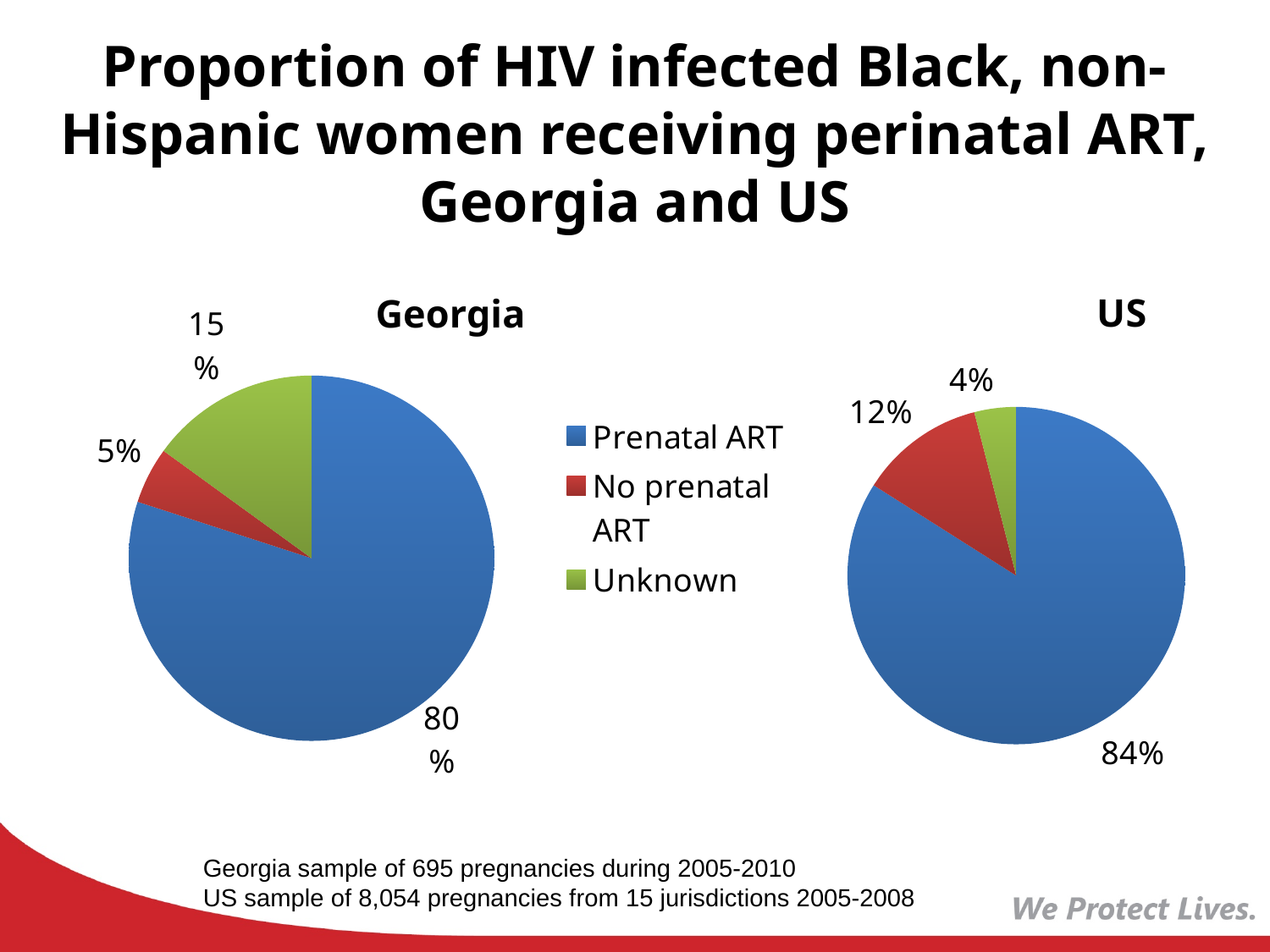
Which chart shows a larger share for No prenatal ART, Georgia or US? US In the US pie chart, what percentage of women received prenatal ART? 84% In the US pie chart, what is the share for No prenatal ART? 12% In the Georgia pie chart, which category has the largest slice? Prenatal ART How many categories does the legend list? 3 What type of chart is used on this slide? Pie chart In the US pie chart, which category has the smallest slice? Unknown In the US pie chart, what is the share for Unknown? 4% In the Georgia pie chart, what is the share for Unknown? 15% In the Georgia pie chart, what is the share for No prenatal ART? 5% What is the difference between the Prenatal ART share in the US chart and in the Georgia chart? 4% In the Georgia pie chart, what percentage of women received prenatal ART? 80%